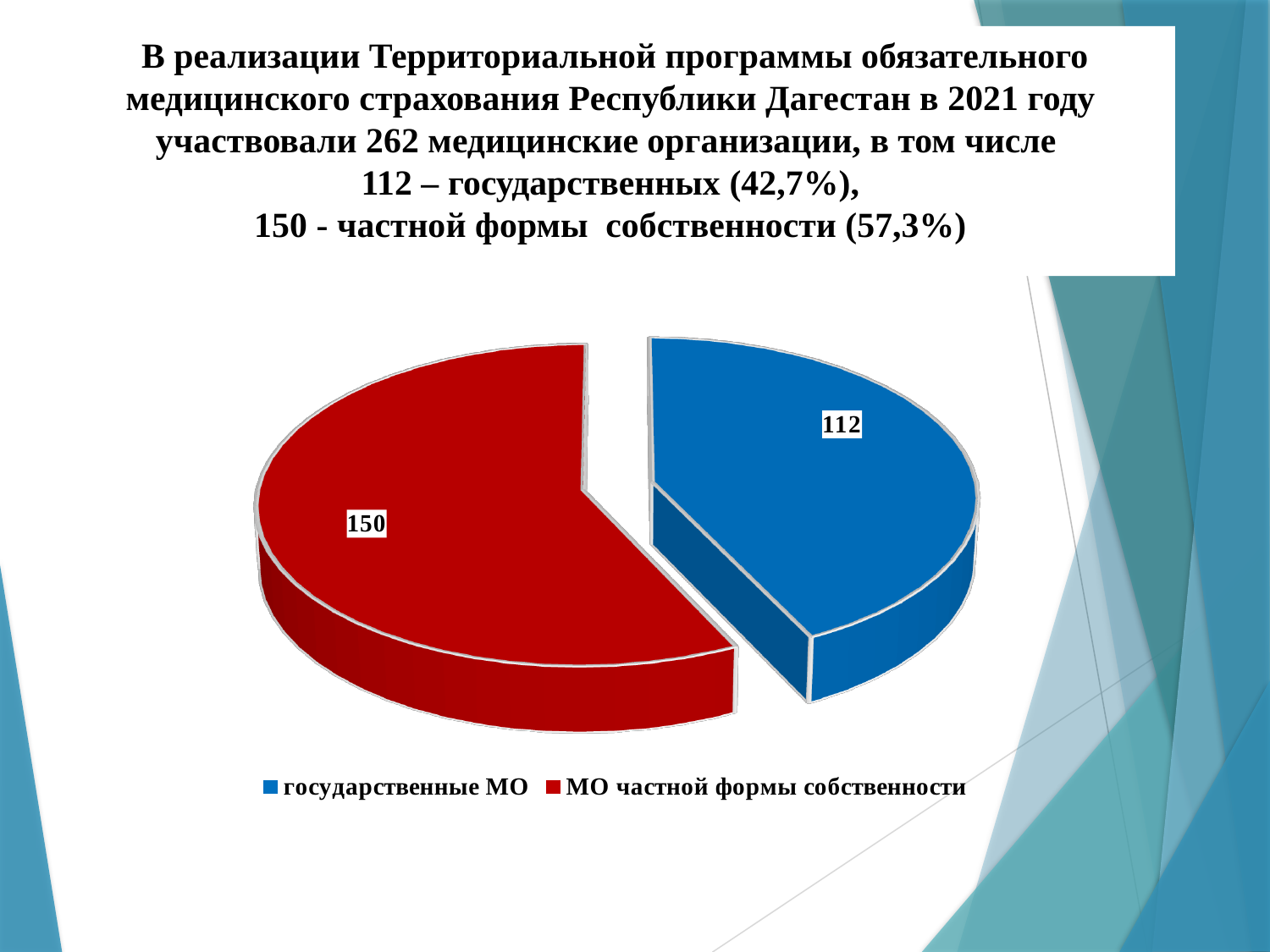
How many entries does the legend list? 2 What colour is the slice for МО частной формы собственности? red How many slices does the pie chart have? 2 What is the value for МО частной формы собственности? 150 What is the total of the two slices? 262 What is the difference between the values for МО частной формы собственности and государственные МО? 38 What is the value for государственные МО? 112 What kind of chart is shown on the slide? pie chart What share of the pie does государственные МО represent? 42,7% Which is larger: государственные МО or МО частной формы собственности? МО частной формы собственности Which category has the smallest slice? государственные МО Which category has the largest slice? МО частной формы собственности